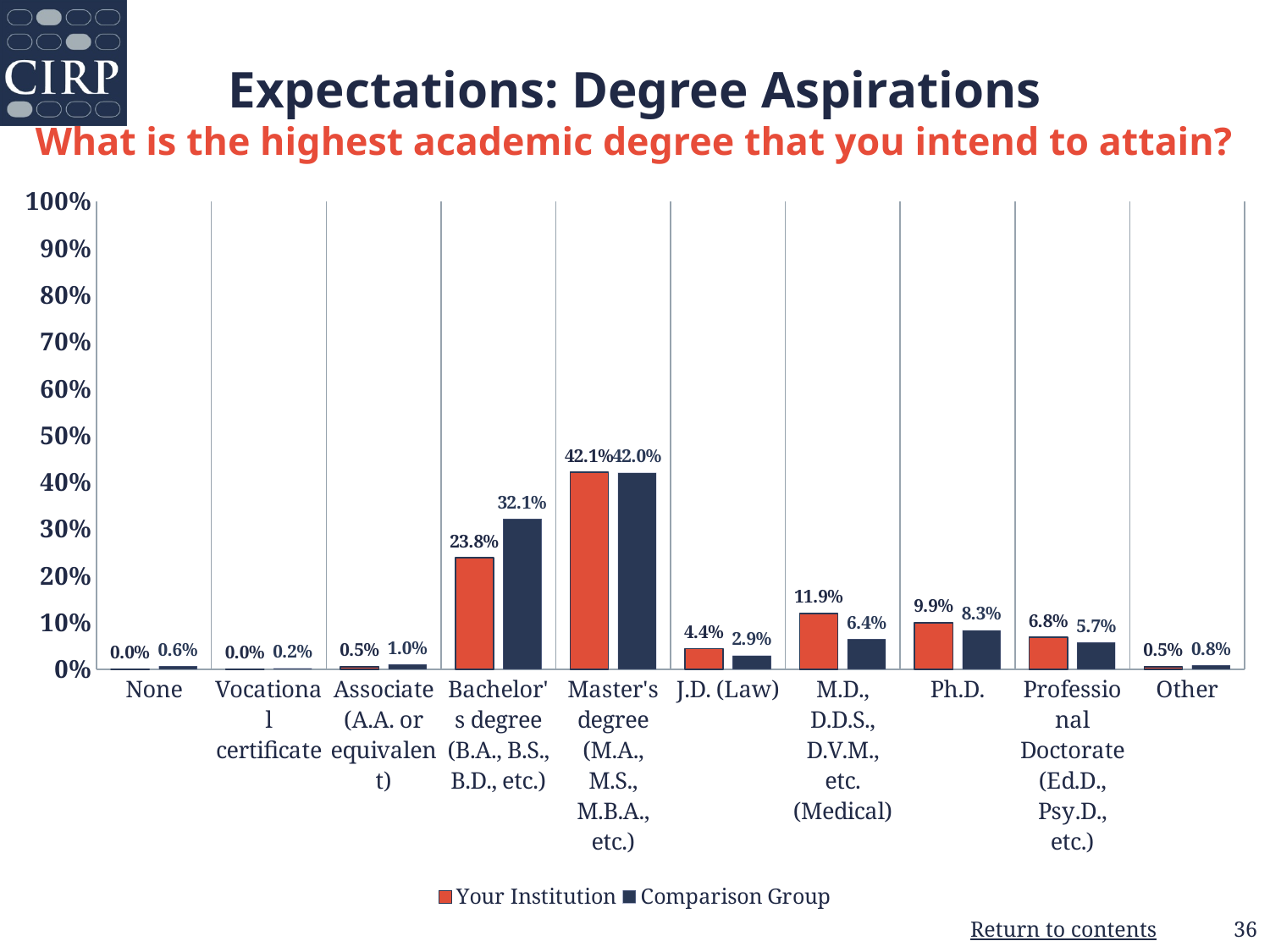
How many categories are shown on the x axis? 10 What is the value for Comparison Group for Bachelor's degree? 32.1% How many series does the legend list? 2 What is the value for Your Institution for Master's degree? 42.1% Which is larger for Ph.D., Your Institution or Comparison Group? Your Institution What is the difference between Comparison Group and Your Institution for Bachelor's degree? 8.3% What kind of chart is shown on the slide? bar chart What is the value for Your Institution for M.D., D.D.S., D.V.M., etc. (Medical)? 11.9% What is the difference between Your Institution and Comparison Group for J.D. (Law)? 1.5% Which series is shown in orange in the legend? Your Institution Is the value for Your Institution for Bachelor's degree greater or less than 20%? greater Which category has the highest value for Your Institution? Master's degree